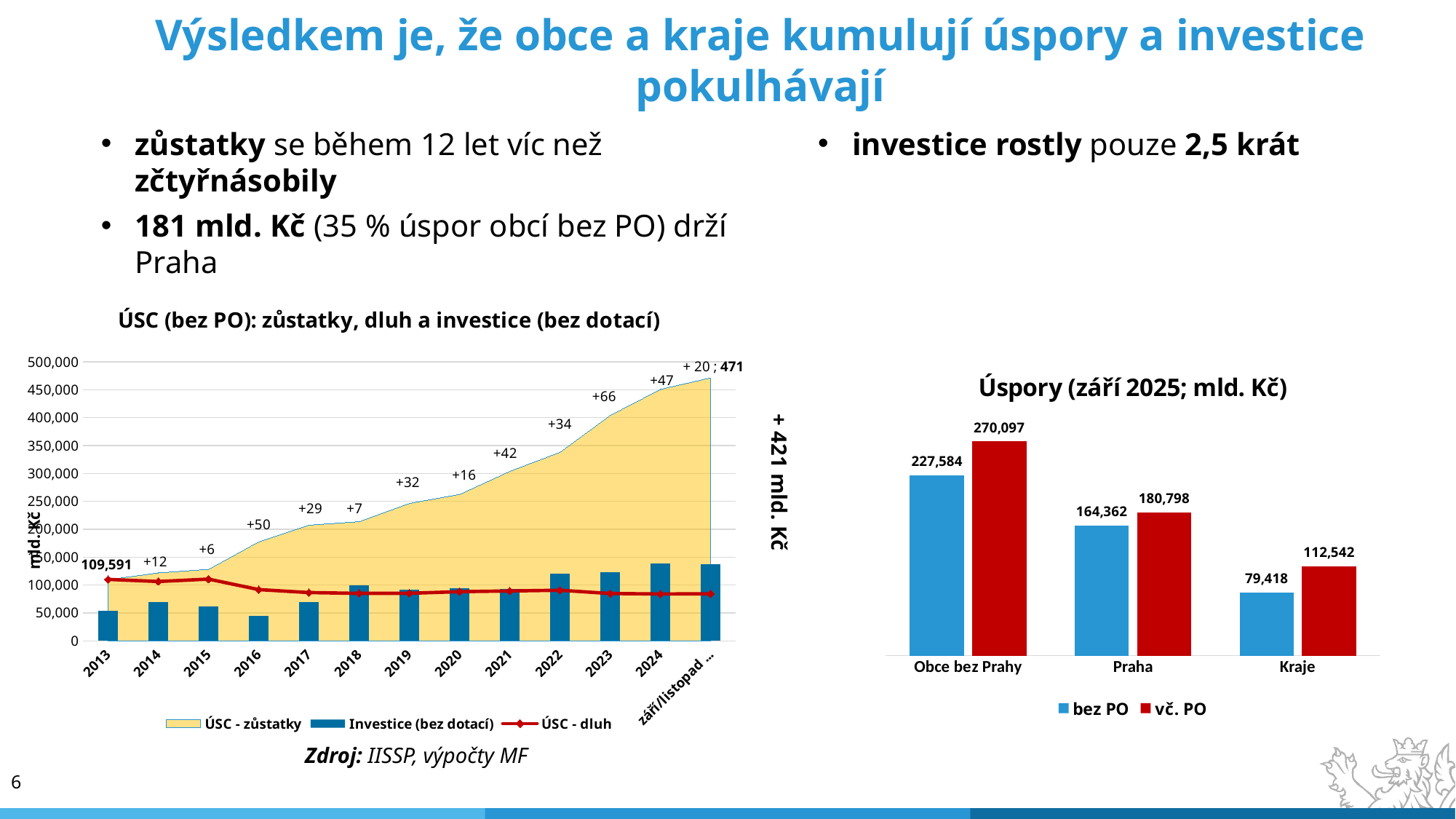
How many series does the legend of the chart 'Úspory (září 2025; mld. Kč)' list? 2 In the chart 'ÚSC (bez PO): zůstatky, dluh a investice (bez dotací)', what is the 'ÚSC - zůstatky' value for 2013? 109,591 In the chart 'ÚSC (bez PO): zůstatky, dluh a investice (bez dotací)', is the 'Investice (bez dotací)' value for 2024 greater or less than 100,000? greater In the chart 'Úspory (září 2025; mld. Kč)', what is the 'bez PO' value for Praha? 164,362 In the chart 'Úspory (září 2025; mld. Kč)', which category has the highest 'bez PO' value? Obce bez Prahy In the chart 'Úspory (září 2025; mld. Kč)', what is the 'vč. PO' value for Kraje? 112,542 In the chart 'Úspory (září 2025; mld. Kč)', what is the difference between the 'vč. PO' and 'bez PO' values for Obce bez Prahy? 42,513 In the chart 'ÚSC (bez PO): zůstatky, dluh a investice (bez dotací)', do the 'ÚSC - zůstatky' values generally rise or fall from 2013 onwards? rise What kind of chart is 'Úspory (září 2025; mld. Kč)'? bar chart In the chart 'Úspory (září 2025; mld. Kč)', which is larger: the 'vč. PO' value for Praha or for Kraje? Praha How many categories are shown on the x axis of the chart 'Úspory (září 2025; mld. Kč)'? 3 How many series does the legend of the chart 'ÚSC (bez PO): zůstatky, dluh a investice (bez dotací)' list? 3